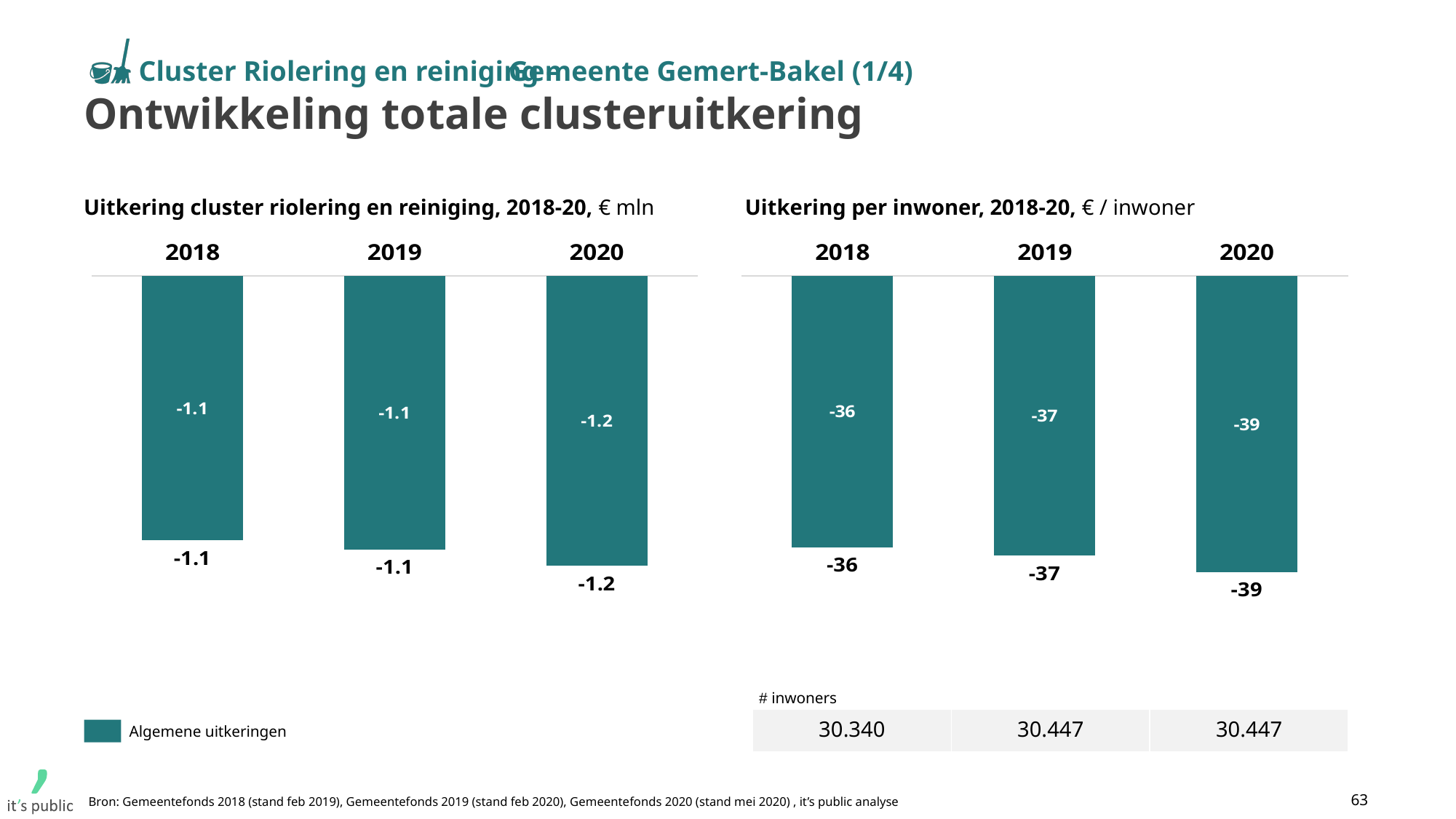
How many years are shown in the left chart (Uitkering cluster riolering en reiniging)? 3 In the left chart (Uitkering cluster riolering en reiniging), what is the value for 2018? -1.1 In the right chart (Uitkering per inwoner), what is the value for 2020? -39 What is the legend entry shown below the left chart? Algemene uitkeringen In the left chart (Uitkering cluster riolering en reiniging), what is the difference between the 2019 value and the 2020 value? 0.1 In the right chart (Uitkering per inwoner), which year has the highest (least negative) value? 2018 In the right chart (Uitkering per inwoner), is the value for 2018 or for 2020 more negative? 2020 In the left chart (Uitkering cluster riolering en reiniging), what is the value for 2020? -1.2 In the right chart (Uitkering per inwoner), what is the value for 2019? -37 What kind of chart is the right chart (Uitkering per inwoner)? Bar chart In the right chart (Uitkering per inwoner), which year has the lowest (most negative) value? 2020 In the right chart (Uitkering per inwoner), what is the difference between the 2018 value and the 2020 value? 3